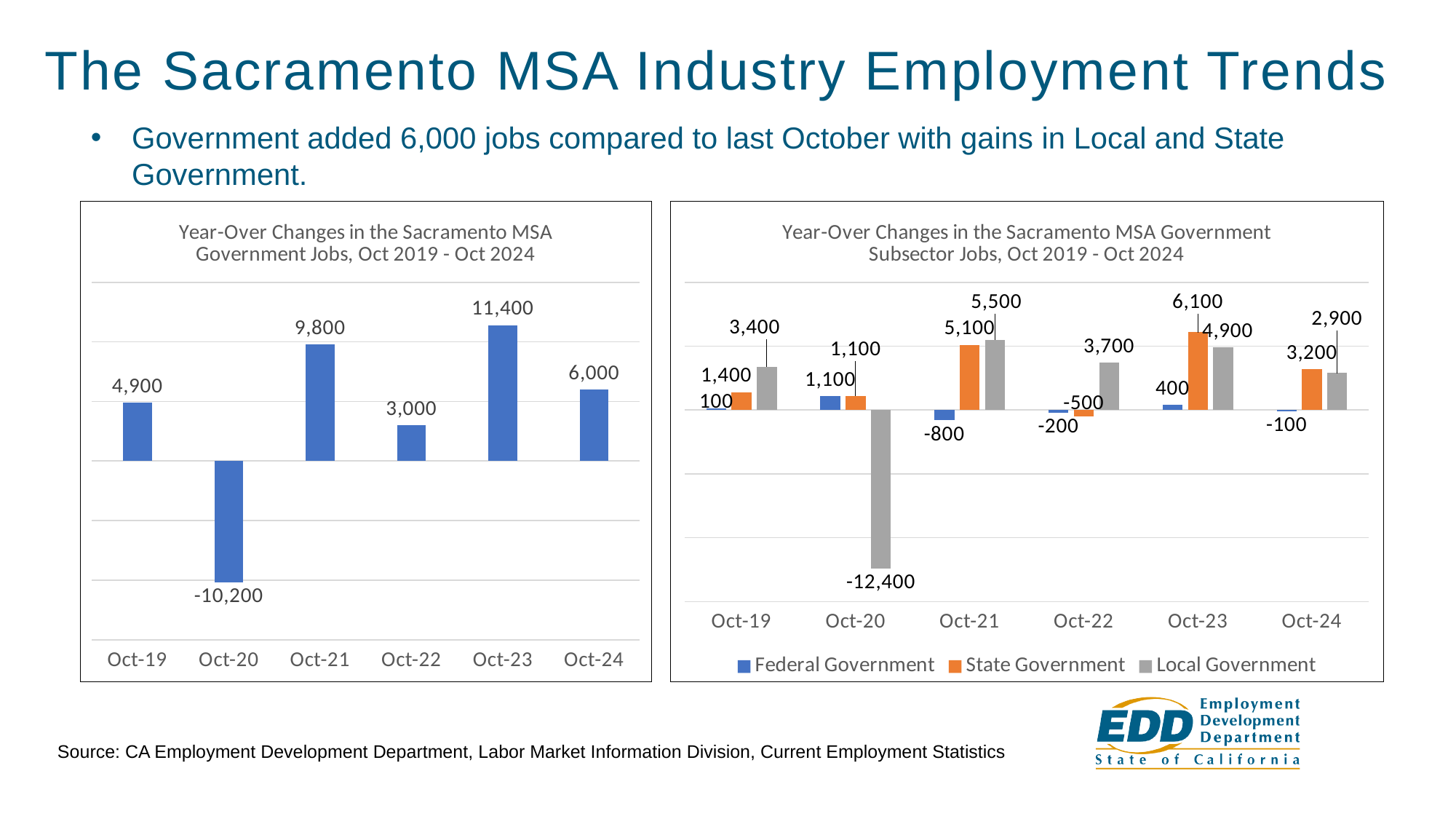
In the right chart (Government Subsector Jobs), which is larger for Oct-24: State Government or Local Government? State Government In the right chart (Government Subsector Jobs), what is the difference between the State Government and Federal Government values for Oct-21? 5,900 In the left chart (Year-Over Changes in the Sacramento MSA Government Jobs), which period has the lowest value? Oct-20 In the right chart (Government Subsector Jobs), how many series does the legend list? 3 In the right chart (Government Subsector Jobs), what is the Local Government value for Oct-20? -12,400 In the left chart (Year-Over Changes in the Sacramento MSA Government Jobs), what is the value for Oct-20? -10,200 What kind of chart is the left chart (Year-Over Changes in the Sacramento MSA Government Jobs)? Bar chart In the left chart (Year-Over Changes in the Sacramento MSA Government Jobs), how many periods are shown on the x axis? 6 In the right chart (Government Subsector Jobs), what is the State Government value for Oct-23? 6,100 In the left chart (Year-Over Changes in the Sacramento MSA Government Jobs), what is the difference between the Oct-21 and Oct-22 values? 6,800 In the left chart (Year-Over Changes in the Sacramento MSA Government Jobs), which period has the highest value? Oct-23 In the left chart (Year-Over Changes in the Sacramento MSA Government Jobs), what is the value for Oct-23? 11,400